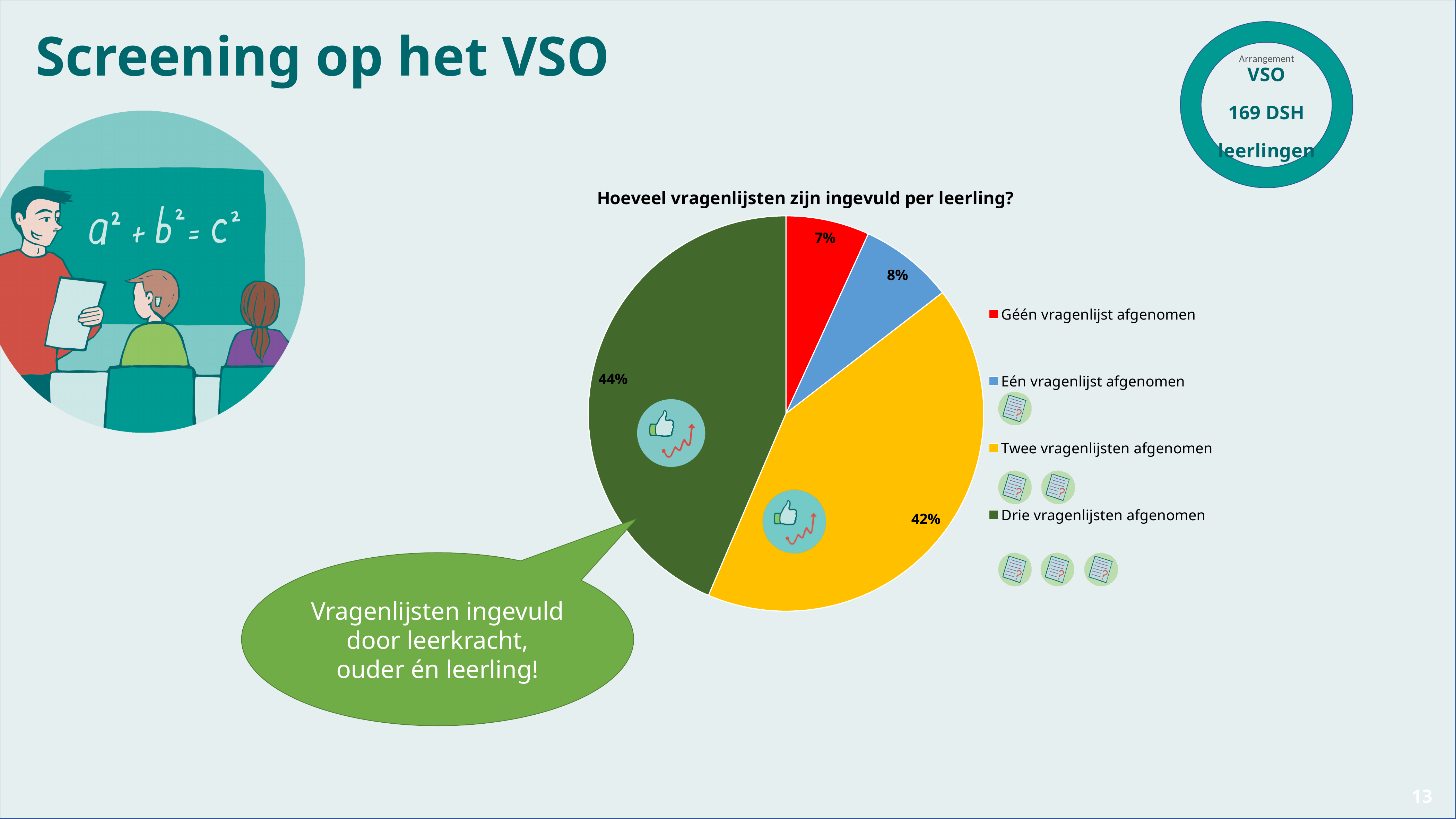
What is the difference in percentage points between 'Drie vragenlijsten afgenomen' and 'Twee vragenlijsten afgenomen'? 2 How many categories does the pie chart have? 4 Which category has the smallest slice of the pie? Géén vragenlijst afgenomen What percentage of the pie is 'Eén vragenlijst afgenomen'? 8% Which category has the largest slice of the pie? Drie vragenlijsten afgenomen What percentage of the pie is 'Twee vragenlijsten afgenomen'? 42% What percentage of the pie is 'Drie vragenlijsten afgenomen'? 44% What is the title of the pie chart? Hoeveel vragenlijsten zijn ingevuld per leerling? Which is larger: the slice for 'Eén vragenlijst afgenomen' or the slice for 'Géén vragenlijst afgenomen'? Eén vragenlijst afgenomen What percentage of the pie is 'Géén vragenlijst afgenomen'? 7% What kind of chart is shown on the slide? pie chart What colour is the slice for 'Twee vragenlijsten afgenomen'? yellow